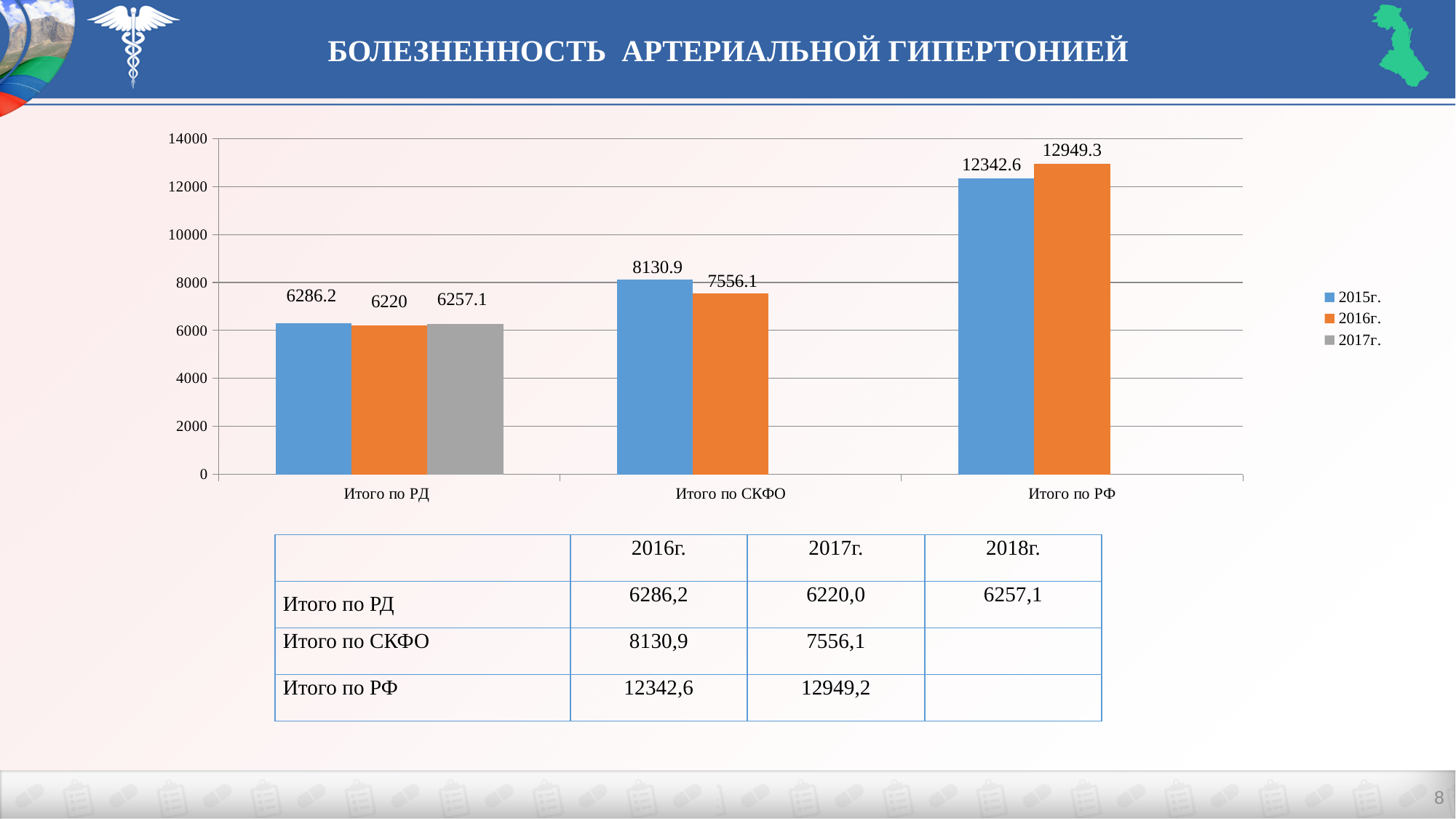
Which is larger for Итого по РФ, the 2015г. value or the 2016г. value? 2016г. What is the value of the 2016г. bar for Итого по РФ? 12949.3 How many categories are shown on the x axis of the chart? 3 Is the 2015г. value for Итого по СКФО greater or less than 8000? greater What is the value of the 2017г. bar for Итого по РД? 6257.1 What is the value of the 2016г. bar for Итого по СКФО? 7556.1 Which category has the lowest 2016г. value? Итого по РД How many series does the chart legend list? 3 What is the difference between the 2015г. and 2016г. values for Итого по СКФО? 574.8 What type of chart is shown on the slide? bar chart What is the value of the 2015г. bar for Итого по РД? 6286.2 Which category has the highest 2015г. value? Итого по РФ